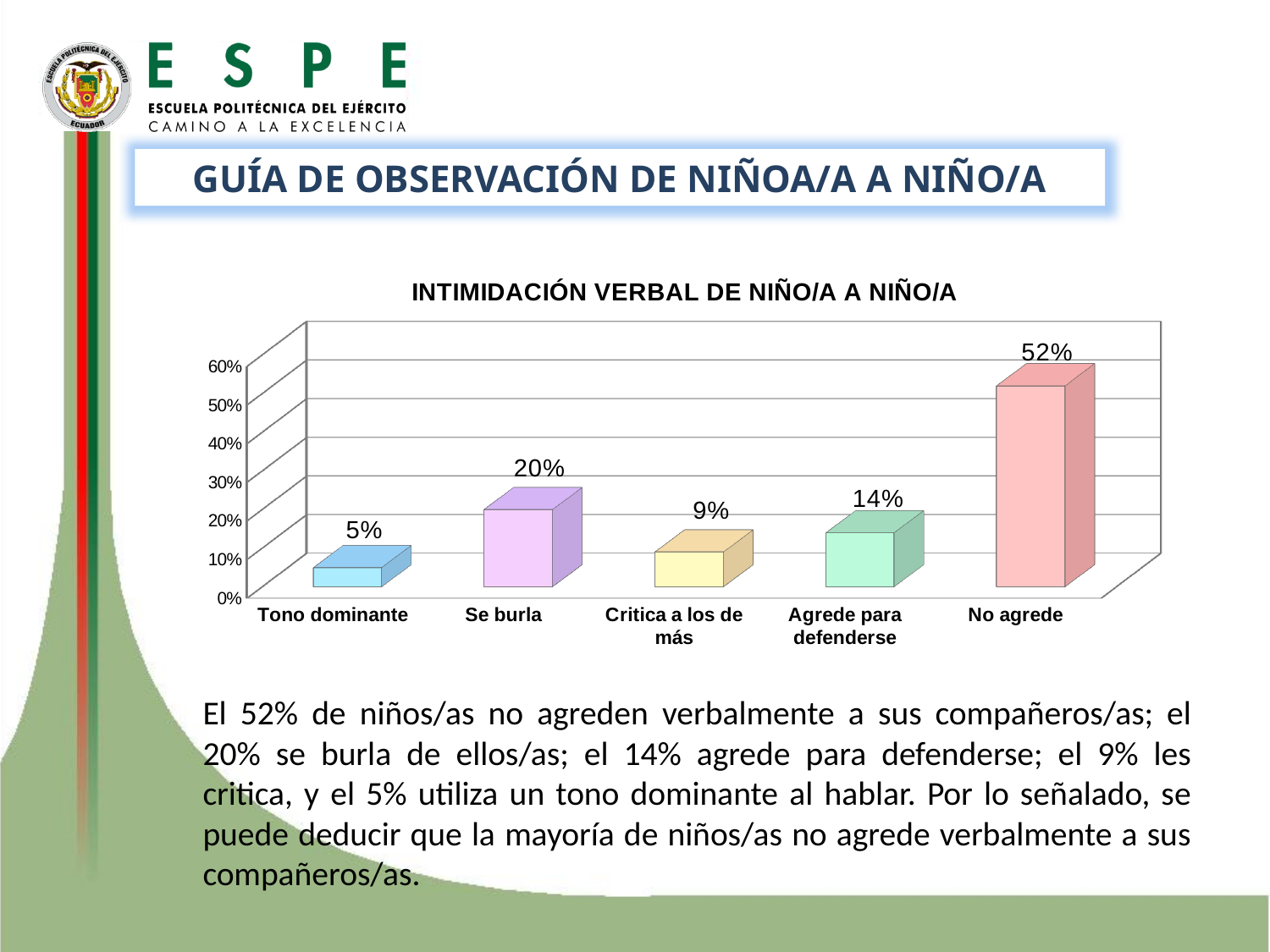
What is the difference between the values for "No agrede" and "Se burla"? 32% What kind of chart is shown on the slide? Bar chart What is the value for "No agrede"? 52% Which is larger, the value for "Critica a los de más" or the value for "Agrede para defenderse"? Agrede para defenderse Which category has the highest value? No agrede What is the value for "Se burla"? 20% Which category has the lowest value? Tono dominante What is the title of the chart? INTIMIDACIÓN VERBAL DE NIÑO/A A NIÑO/A Is the value for "No agrede" greater or less than 40%? greater What is the value for "Agrede para defenderse"? 14% What is the value for "Tono dominante"? 5% How many categories are shown on the x axis? 5